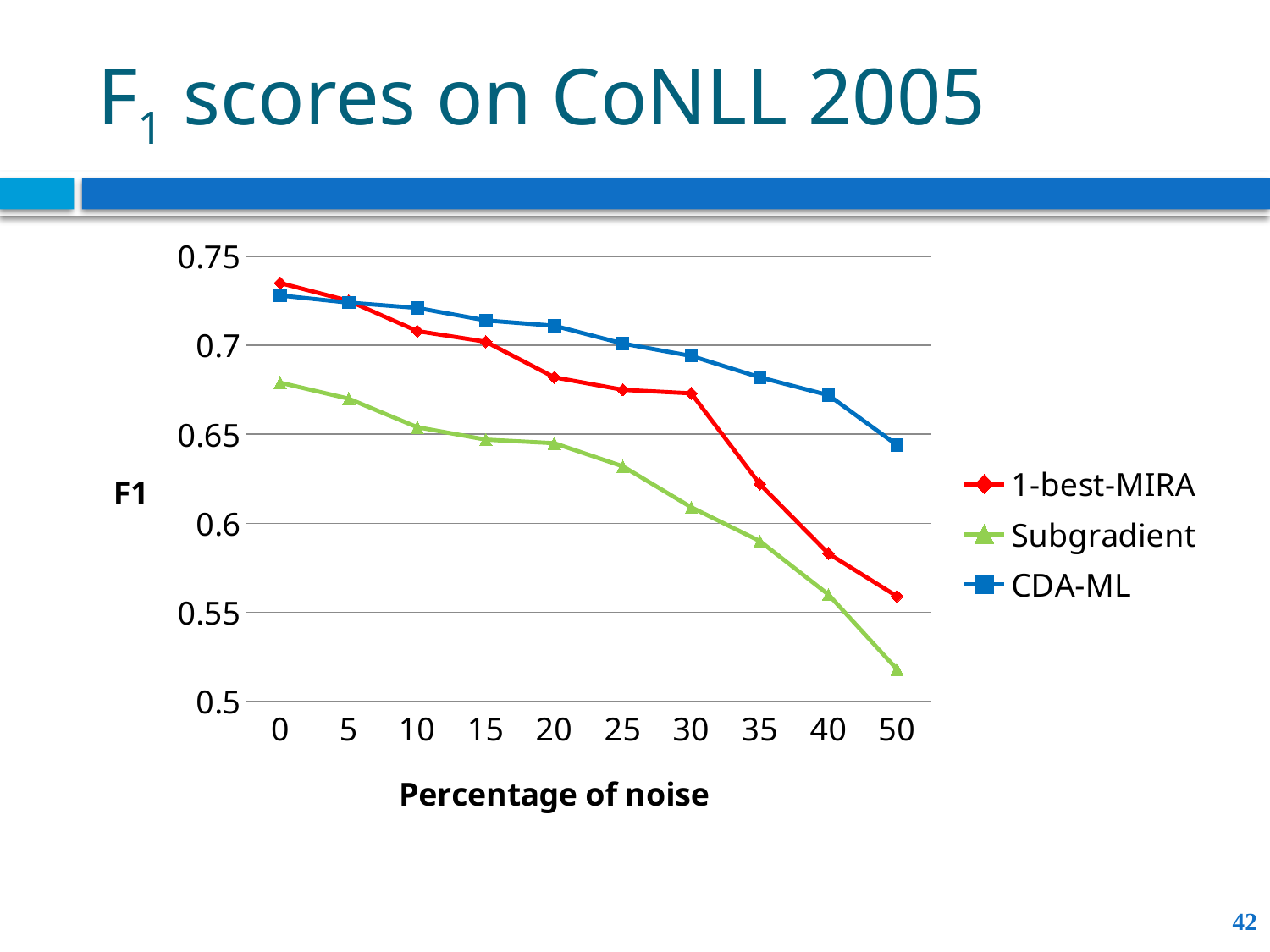
Is the 1-best-MIRA F1 score at 35% noise greater or less than 0.65? less How many series does the legend list? 3 How many noise percentage values are plotted along the x axis? 10 Do the F1 scores rise or fall as the percentage of noise increases? fall Is the CDA-ML F1 score at 50% noise greater or less than 0.6? greater What is the label of the x axis? Percentage of noise At 0% noise, which has the higher F1 score, 1-best-MIRA or Subgradient? 1-best-MIRA Is the Subgradient F1 score at 50% noise greater or less than 0.55? less At 50% noise, which has the higher F1 score, CDA-ML or 1-best-MIRA? CDA-ML Which series has the lowest F1 score at 50% noise? Subgradient What kind of chart is shown on the slide? line chart